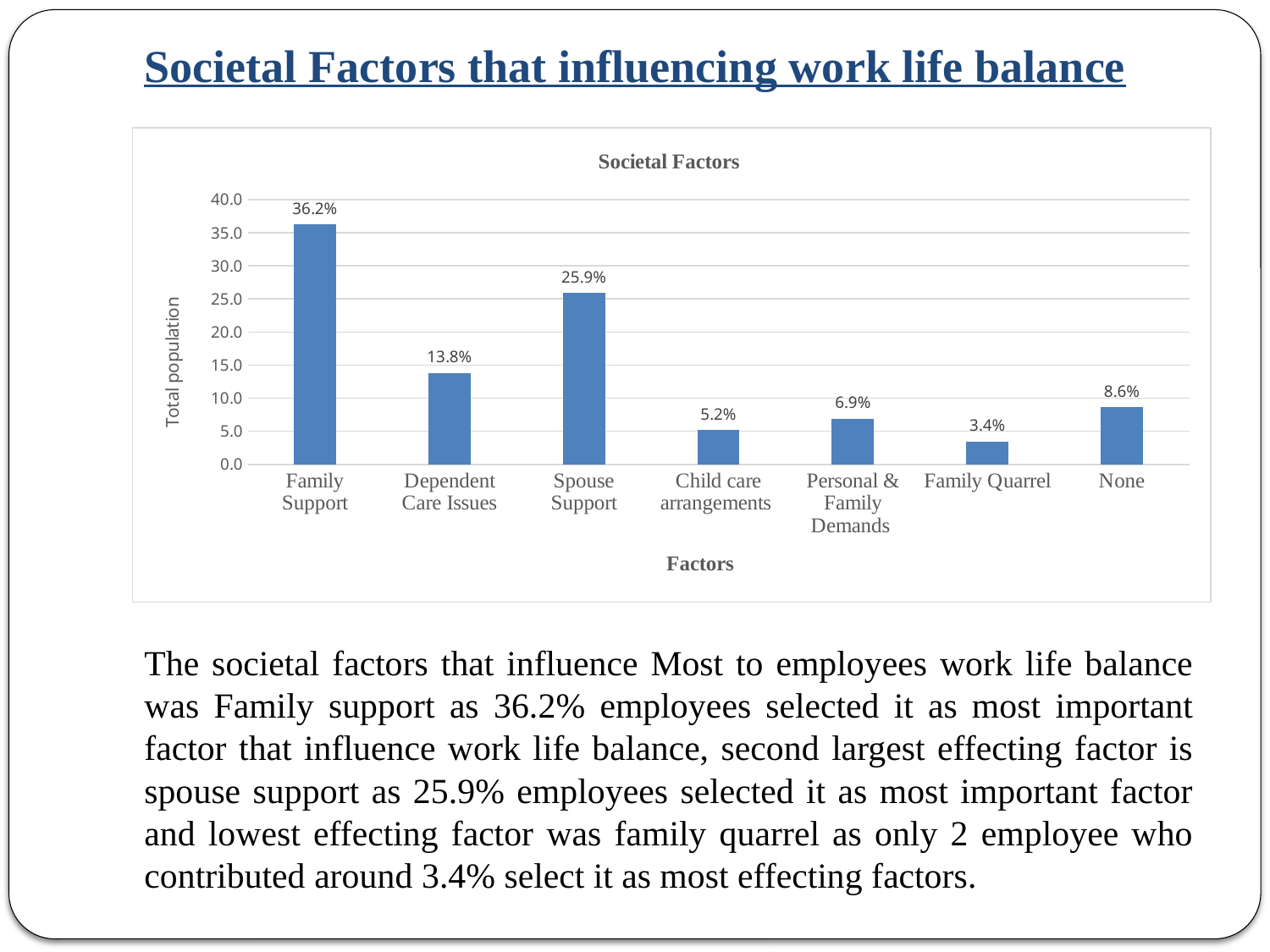
What is the difference between the values for Family Support and Spouse Support? 10.3% What is the title of the chart? Societal Factors What kind of chart is shown on the slide? Bar chart Which factor has the lowest value? Family Quarrel What is the value for Dependent Care Issues? 13.8% What is the value for Family Support? 36.2% What is the value for None? 8.6% What is the value for Child care arrangements? 5.2% Which factor has the highest value? Family Support Which is larger, the value for Personal & Family Demands or the value for None? None How many factors are shown on the x axis? 7 Is the value for Spouse Support greater or less than 20.0? greater